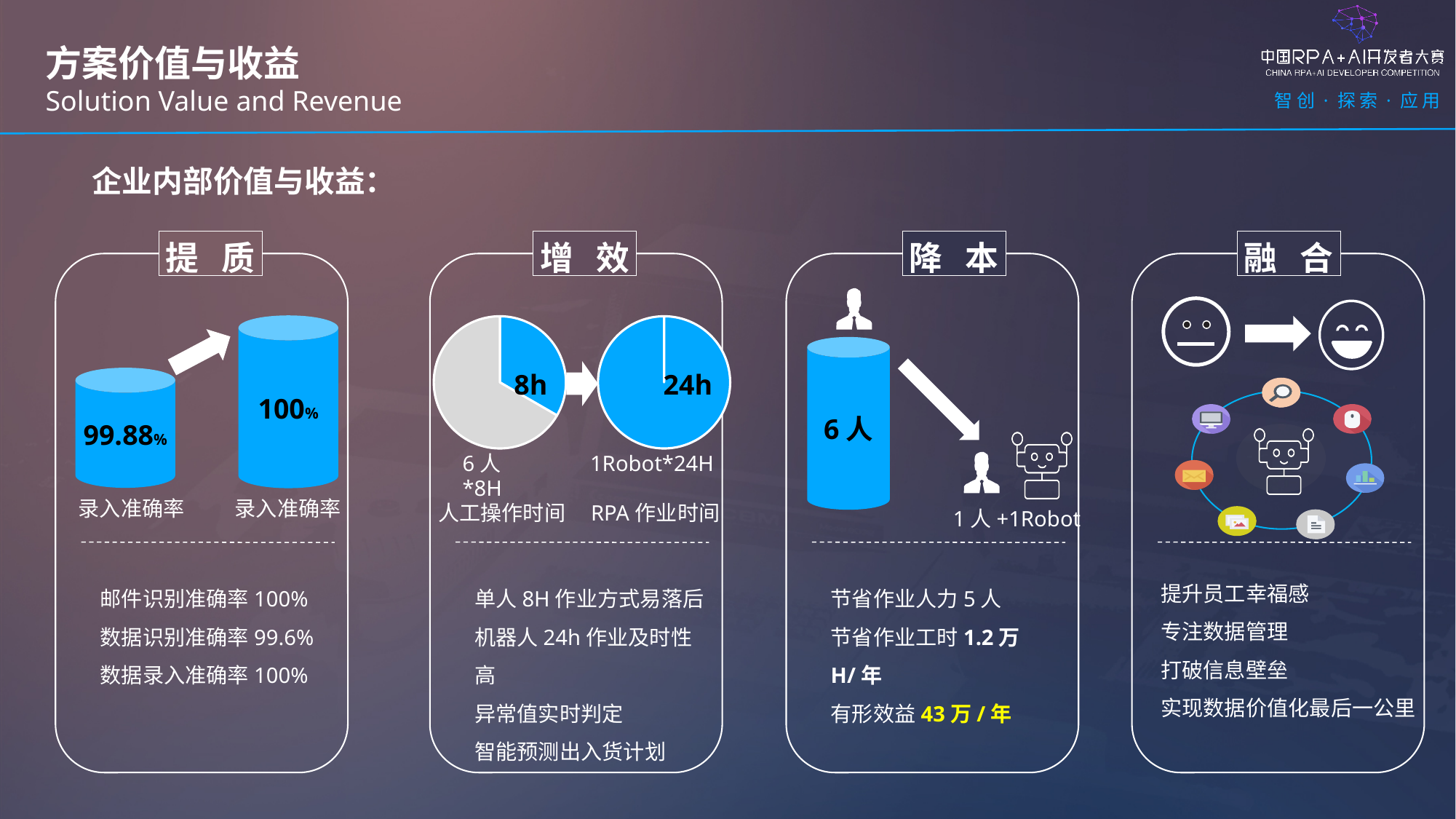
In the 增效 section, how many pie charts are shown? 2 In the 提质 section, do the values rise or fall from the left bar to the right bar? rise In the 提质 section, which cylinder bar shows the larger value, the left or the right? right In the 提质 section, what value is printed on the right cylinder bar? 100% In the 提质 section, what is the difference between the right bar value (100%) and the left bar value (99.88%)? 0.12% In the 降本 section, what value is printed on the cylinder bar? 6 人 In the 增效 section, is the blue slice of the left pie chart more or less than half of the pie? less In the 提质 section, what value is printed on the left cylinder bar? 99.88% In the 增效 section, what kind of chart is used to show 人工操作时间 and RPA 作业时间? pie chart In the 提质 section, what label appears under each cylinder bar? 录入准确率 In the 增效 section, what value is printed on the left pie chart? 8h In the 增效 section, what value is printed on the right pie chart? 24h